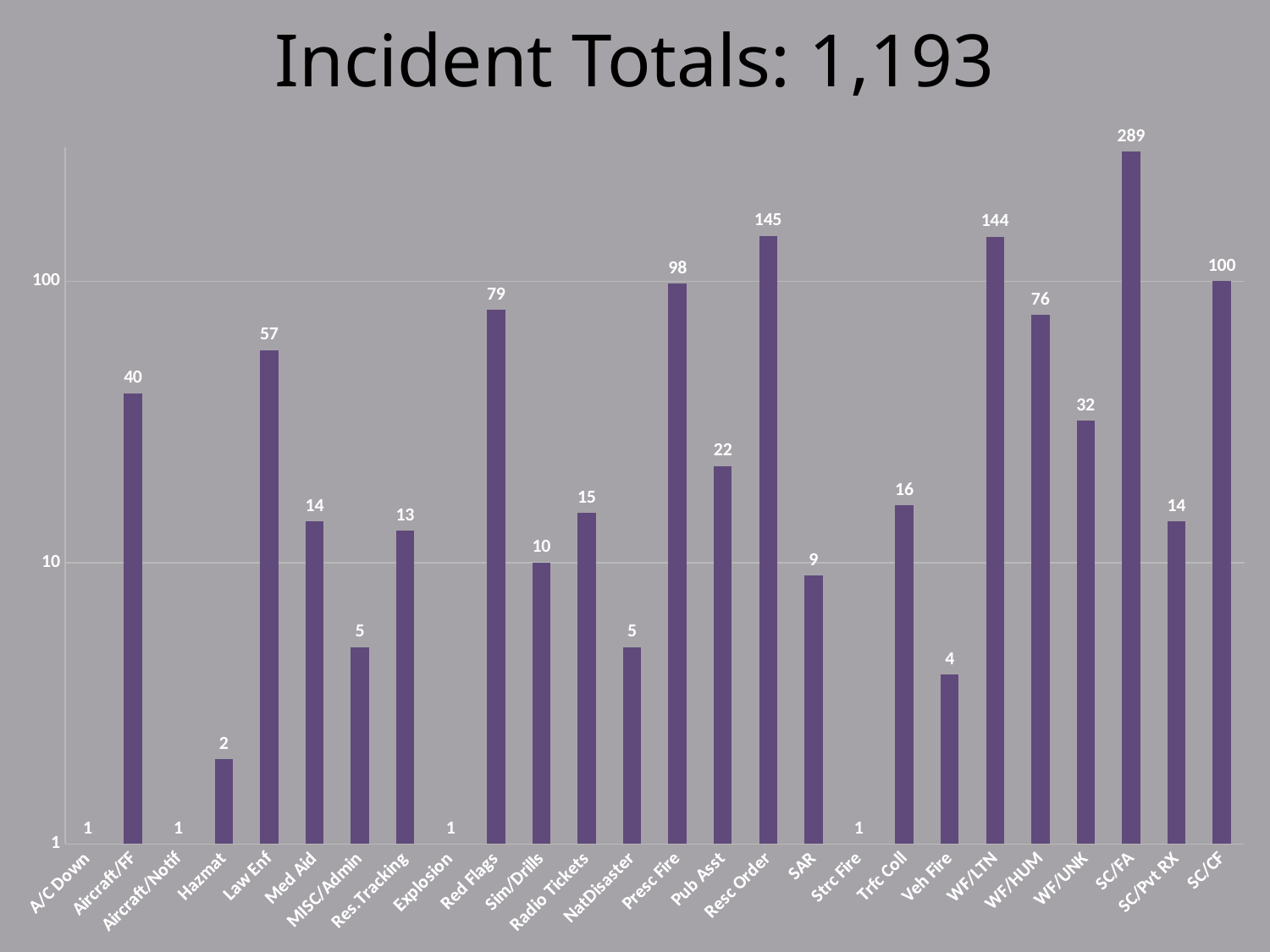
How many categories are shown on the x axis? 26 What is the difference between the values for Pub Asst and Trfc Coll? 6 What is the title of the chart? Incident Totals: 1,193 What kind of chart is shown on the slide? bar chart What is the value for Presc Fire? 98 What is the value for WF/HUM? 76 Which category has the highest value? SC/FA Which is larger, the value for Red Flags or the value for Law Enf? Red Flags What is the difference between the values for SC/FA and SC/CF? 189 What is the value for Trfc Coll? 16 Which is larger, the value for Aircraft/FF or the value for WF/UNK? Aircraft/FF What is the value for Hazmat? 2